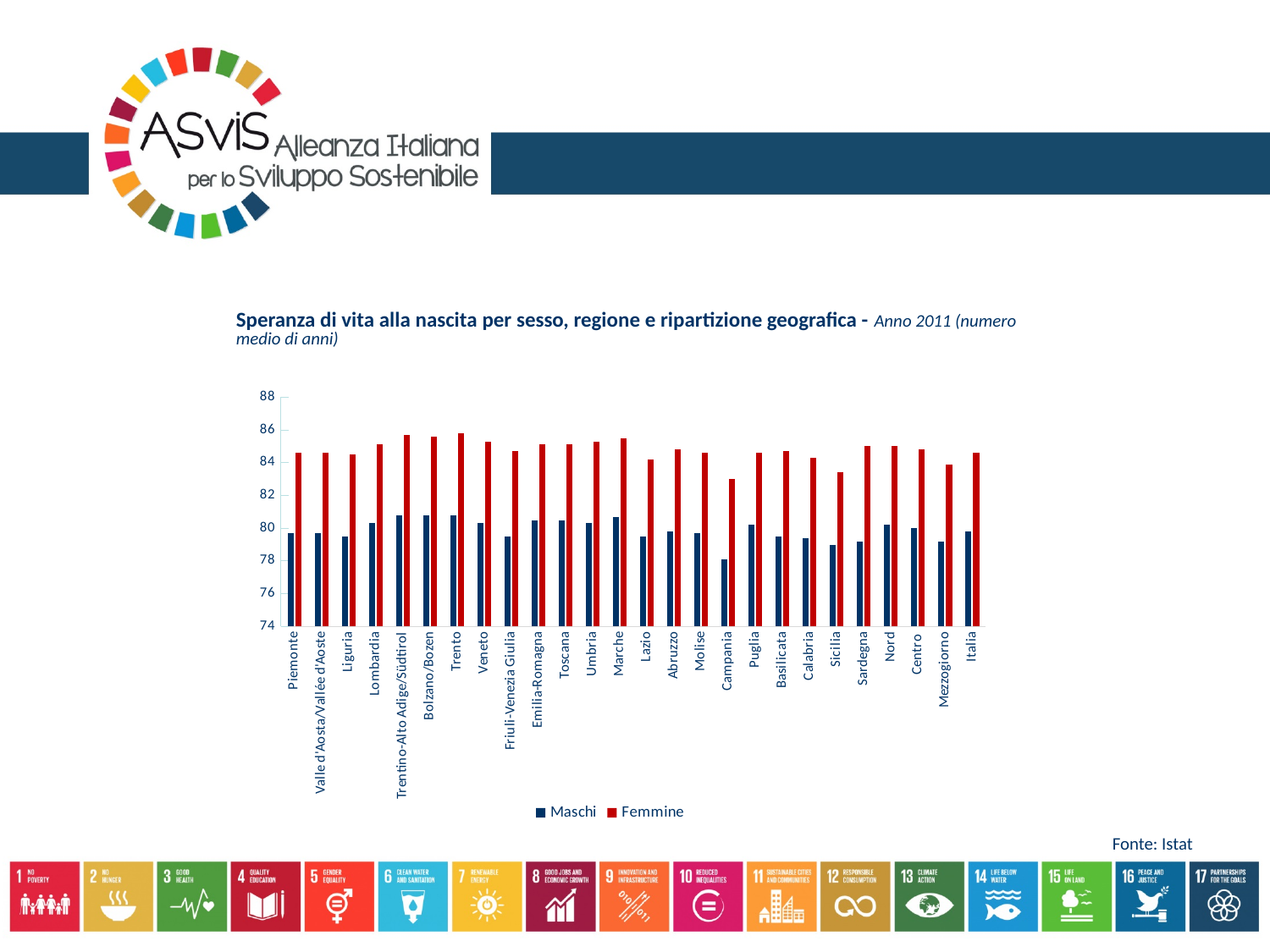
How many series does the legend list? 2 Is the Maschi value for Campania greater or less than 80? less Which category has the lowest value for Maschi? Campania Is the Maschi value for Sicilia greater or less than 80? less What are the two series named in the legend? Maschi and Femmine Is the Femmine value for Trento greater or less than 84? greater What kind of chart is shown on the slide? bar chart For Italia, which series has the larger value, Maschi or Femmine? Femmine Which category has the lowest value for Femmine? Campania How many categories (regions and geographic areas) are shown on the x axis? 26 Which is larger, the Maschi value for Trento or the Maschi value for Campania? Trento